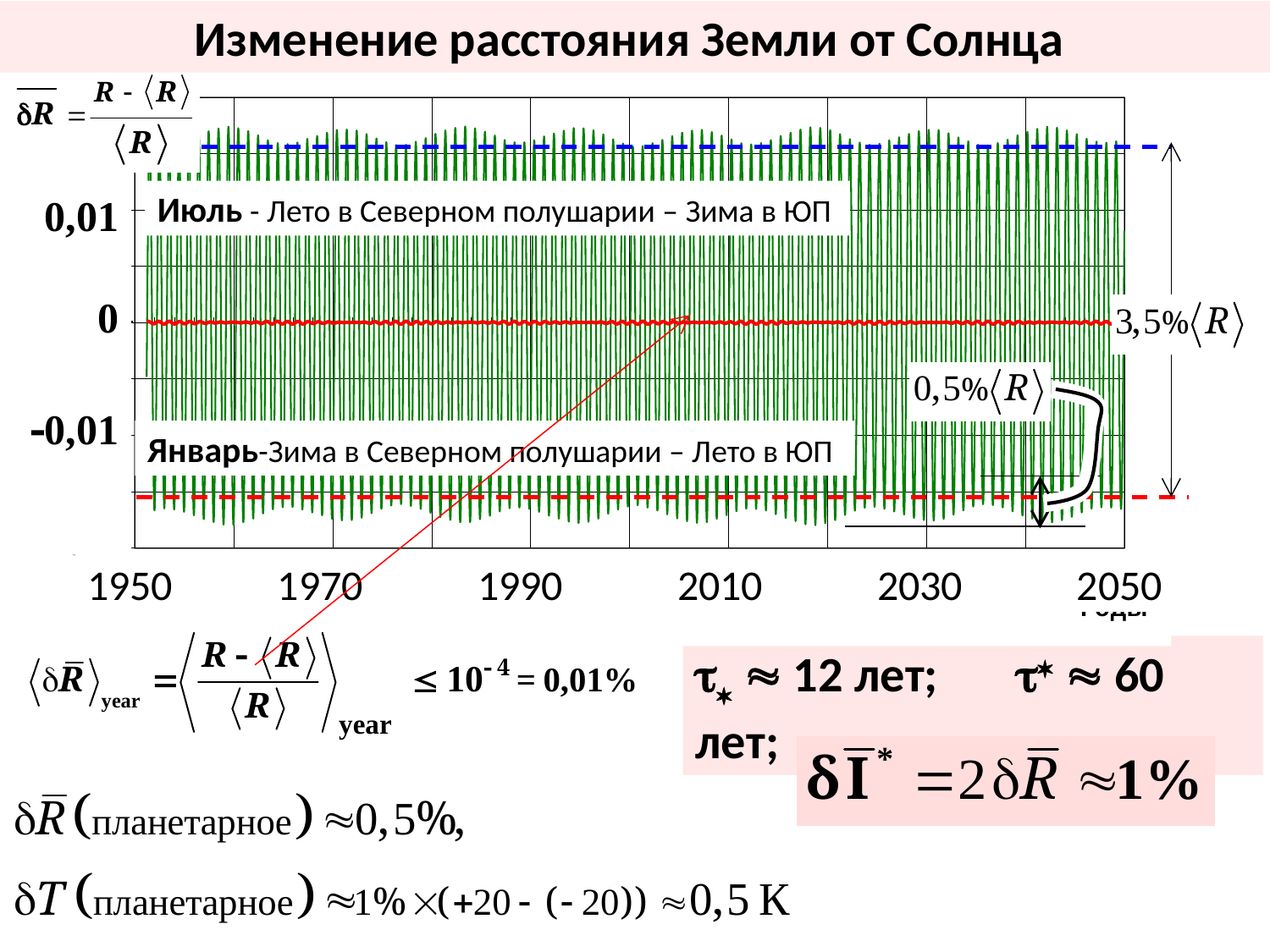
What is the title of the slide chart? Изменение расстояния Земли от Солнца What is the lowest value labelled on the y axis of the chart? -0,01 What is the first year labelled on the x axis of the chart? 1950 Which month is labelled at the upper part of the chart as summer in the Northern Hemisphere? Июль What is the last year labelled on the x axis of the chart? 2050 What kind of chart is shown on the slide? line chart Are the January (Январь) troughs of the green curve greater or less than -0,01? less Does the red line near zero rise, fall, or stay roughly flat from 1950 to 2050? stays roughly flat How many year labels are shown on the x axis of the chart? 6 Are the July (Июль) peaks of the green curve greater or less than 0,01? greater What percentage of ⟨R⟩ is annotated for the full peak-to-trough span on the right of the chart? 3,5% What is the highest value labelled on the y axis of the chart? 0,01